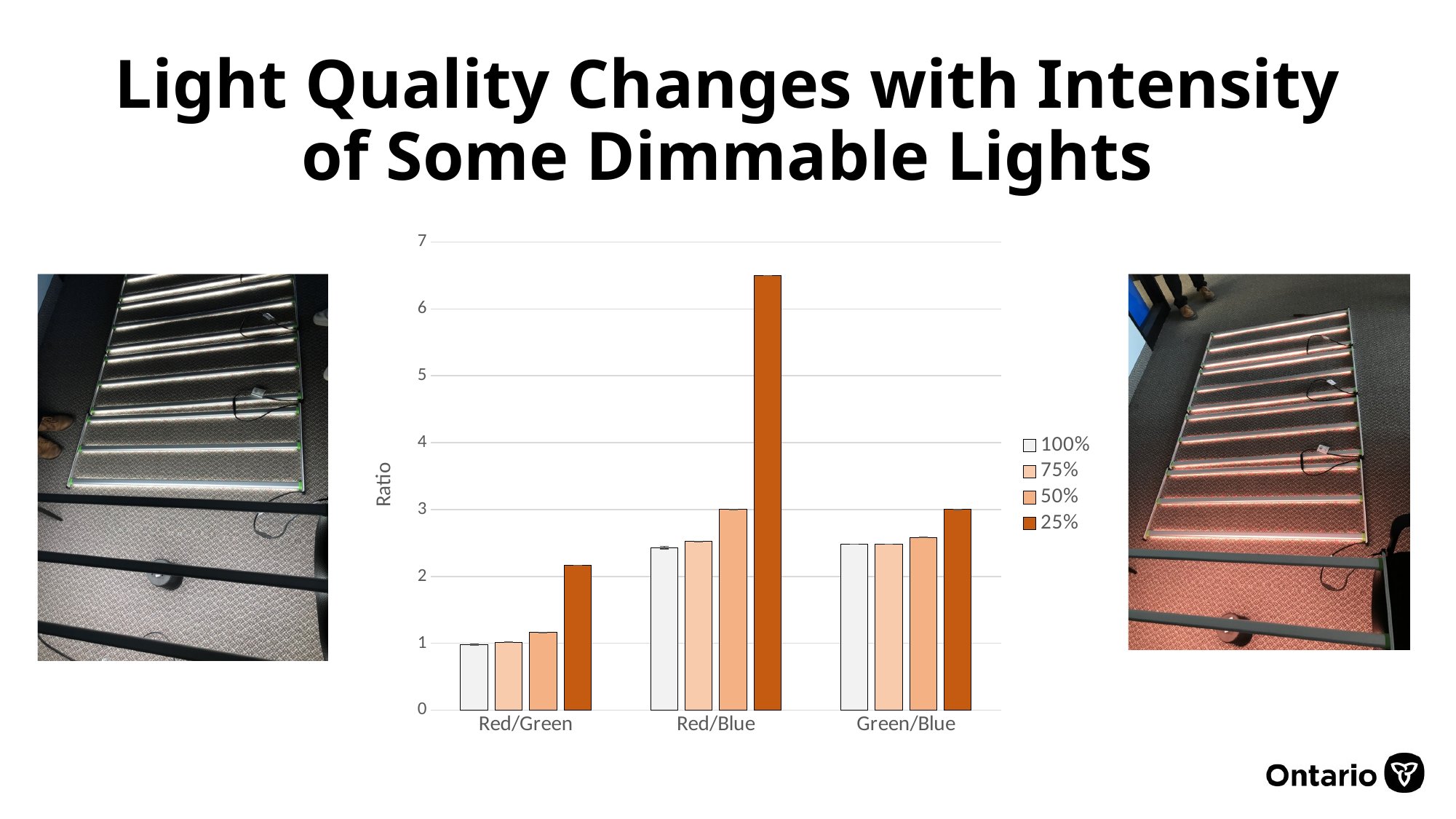
Is the value for 25% in the Red/Blue category greater or less than 6? greater Is the value for 100% in the Red/Green category greater or less than 2? less Which category has the tallest bar in the chart? Red/Blue Which series has the highest value in the Red/Blue category? 25% How many series does the chart legend list? 4 How many categories are shown on the x axis of the chart? 3 What is the label on the y axis of the chart? Ratio Which category has the lowest bar in the chart? Red/Green Within the Red/Blue category, do the bars rise or fall going from 100% to 25%? rise Which is larger in the Green/Blue category, the 25% bar or the 100% bar? 25% Is the value for 25% in the Red/Green category greater or less than 2? greater What kind of chart is shown on the slide? bar chart